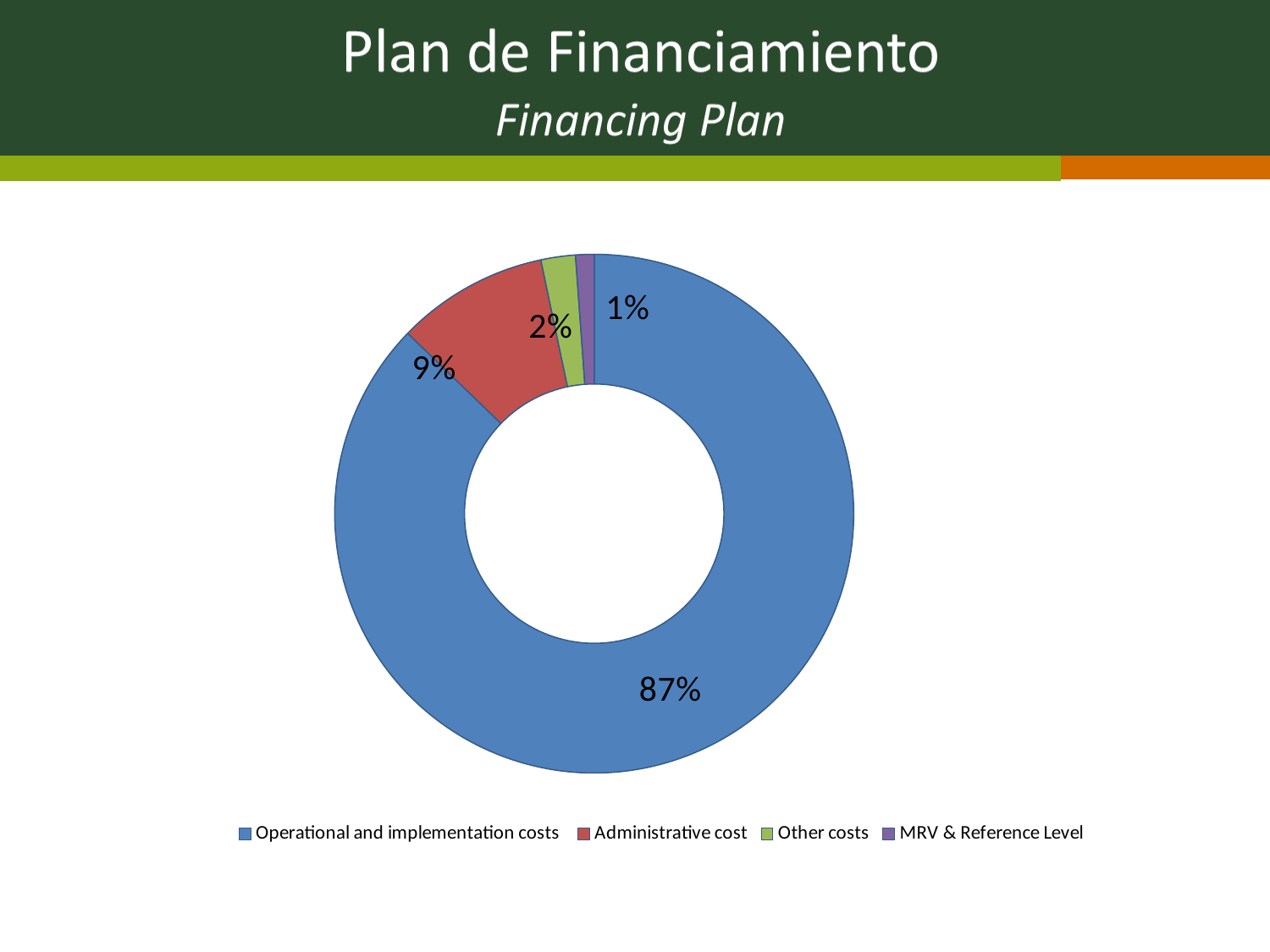
What share of the financing plan goes to MRV & Reference Level? 1% What share of the financing plan goes to Other costs? 2% Which category has the smallest share of the financing plan? MRV & Reference Level What share of the financing plan goes to Operational and implementation costs? 87% What is the difference in percentage points between Operational and implementation costs and Administrative cost? 78 How many categories are shown in the chart? 4 What kind of chart is shown on the slide? Pie chart (doughnut) Which is larger, the share for Administrative cost or the share for Other costs? Administrative cost What is the English title of the slide? Financing Plan What colour represents Administrative cost in the chart? Red Which category has the largest share of the financing plan? Operational and implementation costs